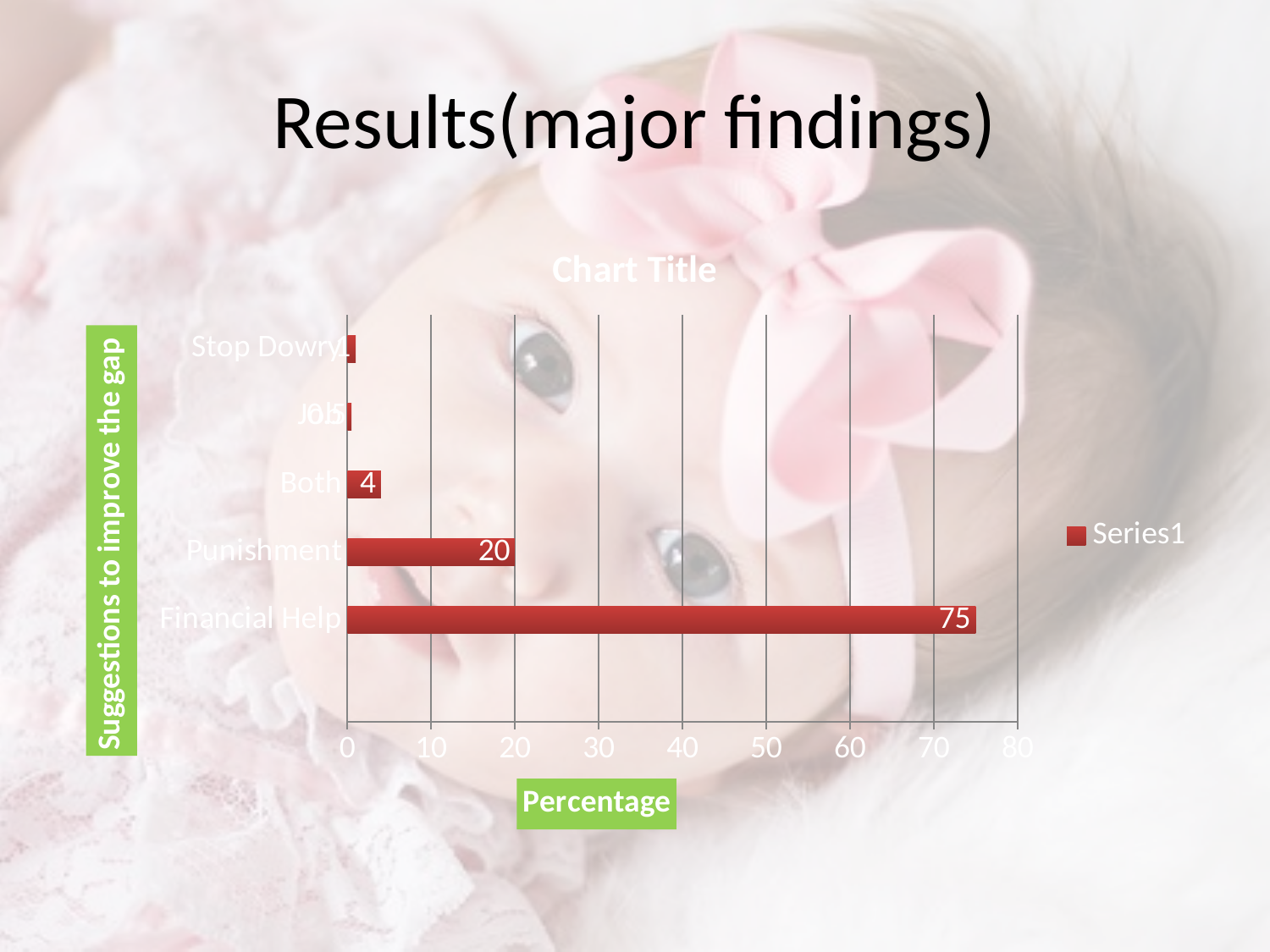
What is the title of the vertical axis? Suggestions to improve the gap What is the difference between the values for Financial Help and Punishment? 55 What is the value for Punishment? 20 How many series does the legend list? 1 What is the title of the horizontal axis? Percentage How many categories are shown on the chart? 5 Which category has the highest value? Financial Help Which is larger, the value for Punishment or the value for Both? Punishment What is the value for Both? 4 What kind of chart is shown on the slide? bar chart Is the value for Financial Help greater or less than 70? greater What is the value for Financial Help? 75